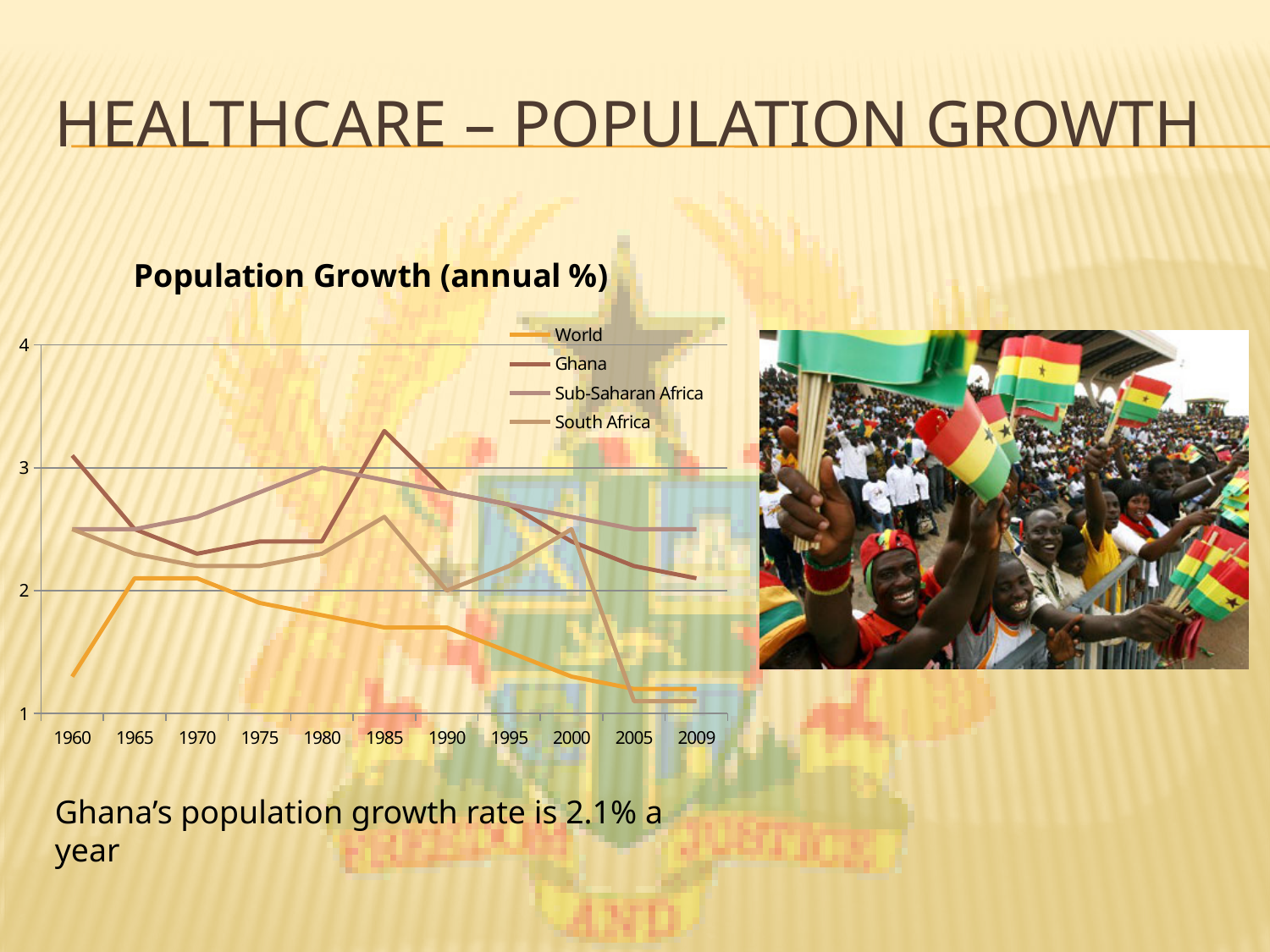
What kind of chart is shown on the slide? Line chart In 2009, which is larger: the value for Sub-Saharan Africa or the value for South Africa? Sub-Saharan Africa Which series is drawn in orange in the chart? World How many series does the chart's legend list? 4 Which series has the highest value in 1985? Ghana What is the title of the chart? Population Growth (annual %) Is the value for South Africa in 2005 greater or less than 2? less How many years are marked along the x axis of the chart? 11 Is the value for Ghana in 1985 greater or less than 3? greater Is the value for World in 1960 greater or less than 2? less Does the World series rise or fall from 1965 to 2009? Fall